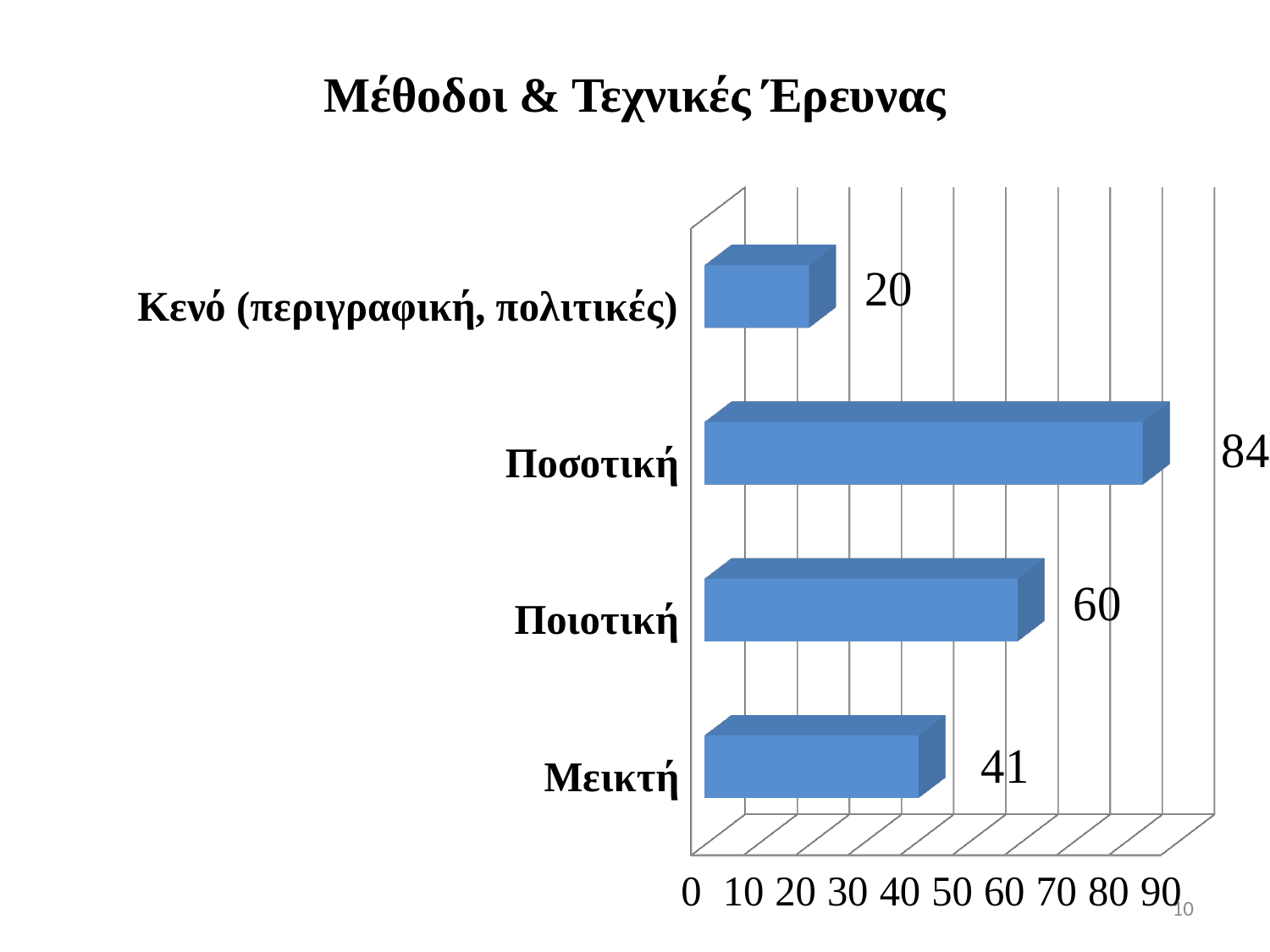
What is the value for Μεικτή? 41 What kind of chart is shown on the slide? Bar chart What is the difference between the values for Ποσοτική and Ποιοτική? 24 Which category has the lowest value? Κενό (περιγραφική, πολιτικές) What is the value for Ποιοτική? 60 Which is larger, the value for Ποιοτική or the value for Μεικτή? Ποιοτική How many categories are shown in the chart? 4 What is the difference between the values for Μεικτή and Κενό (περιγραφική, πολιτικές)? 21 Which category has the highest value? Ποσοτική What is the value for Ποσοτική? 84 What is the value for Κενό (περιγραφική, πολιτικές)? 20 What is the title of the chart? Μέθοδοι & Τεχνικές Έρευνας